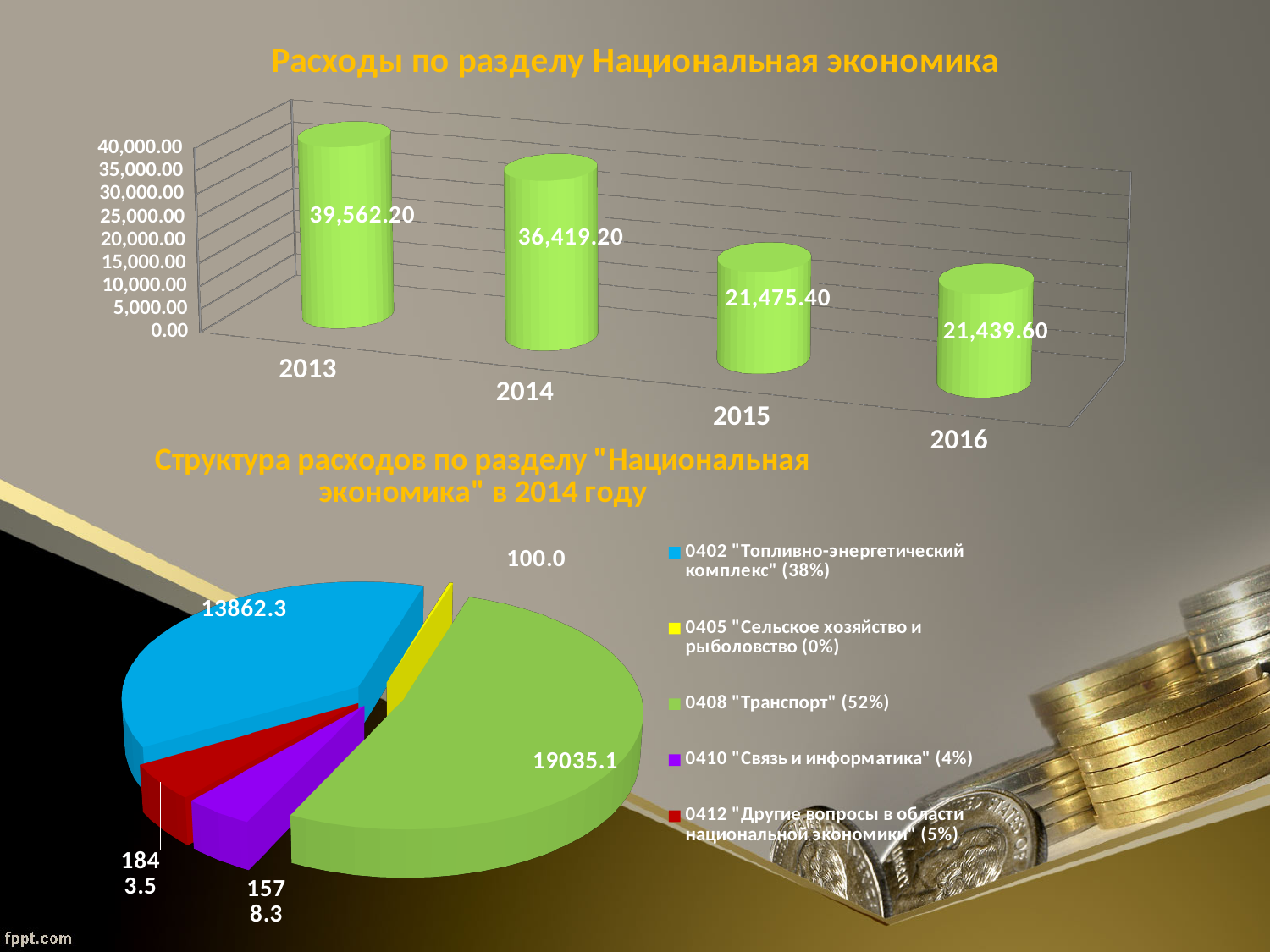
In the chart titled "Расходы по разделу Национальная экономика", how many years are shown on the x axis? 4 In the chart titled "Расходы по разделу Национальная экономика", do the values rise or fall from 2013 to 2016? fall In the pie chart "Структура расходов по разделу "Национальная экономика" в 2014 году", what is the value of the 0408 "Транспорт" slice? 19035.1 In the chart titled "Расходы по разделу Национальная экономика", which year has the highest value? 2013 In the chart titled "Расходы по разделу Национальная экономика", is the value for 2014 greater or less than 35,000.00? greater In the pie chart "Структура расходов по разделу "Национальная экономика" в 2014 году", which category has the smallest slice? 0405 "Сельское хозяйство и рыболовство" In the pie chart "Структура расходов по разделу "Национальная экономика" в 2014 году", how many categories does the legend list? 5 In the chart titled "Расходы по разделу Национальная экономика", what is the value for 2015? 21,475.40 In the chart titled "Расходы по разделу Национальная экономика", what is the value for 2013? 39,562.20 In the chart titled "Расходы по разделу Национальная экономика", what is the difference between the values for 2013 and 2014? 3,143.00 What kind of chart is the top chart titled "Расходы по разделу Национальная экономика"? bar chart In the pie chart "Структура расходов по разделу "Национальная экономика" в 2014 году", what share does the legend give for 0402 "Топливно-энергетический комплекс"? 38%